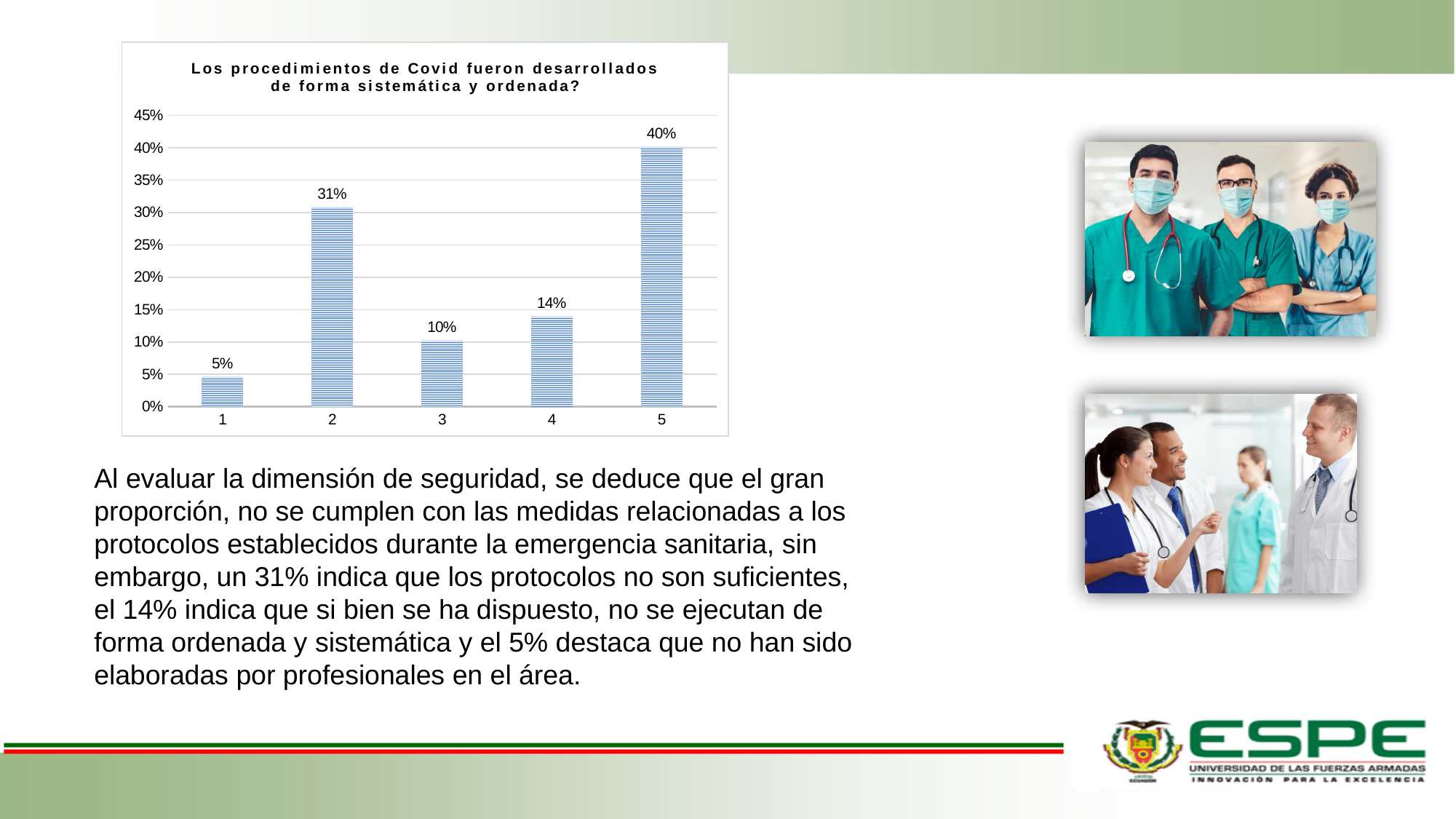
What is the value for category 2? 31% Which is larger, the value for category 3 or the value for category 4? 4 What is the difference between the values for category 5 and category 2? 9% Is the value for category 2 greater or less than 30%? greater What is the value for category 5? 40% What is the value for category 3? 10% What is the title of the chart? Los procedimientos de Covid fueron desarrollados de forma sistemática y ordenada? What is the difference between the values for category 4 and category 1? 9% What kind of chart is shown on the slide? bar chart How many categories are shown on the x axis? 5 Which category has the highest value? 5 Which category has the lowest value? 1